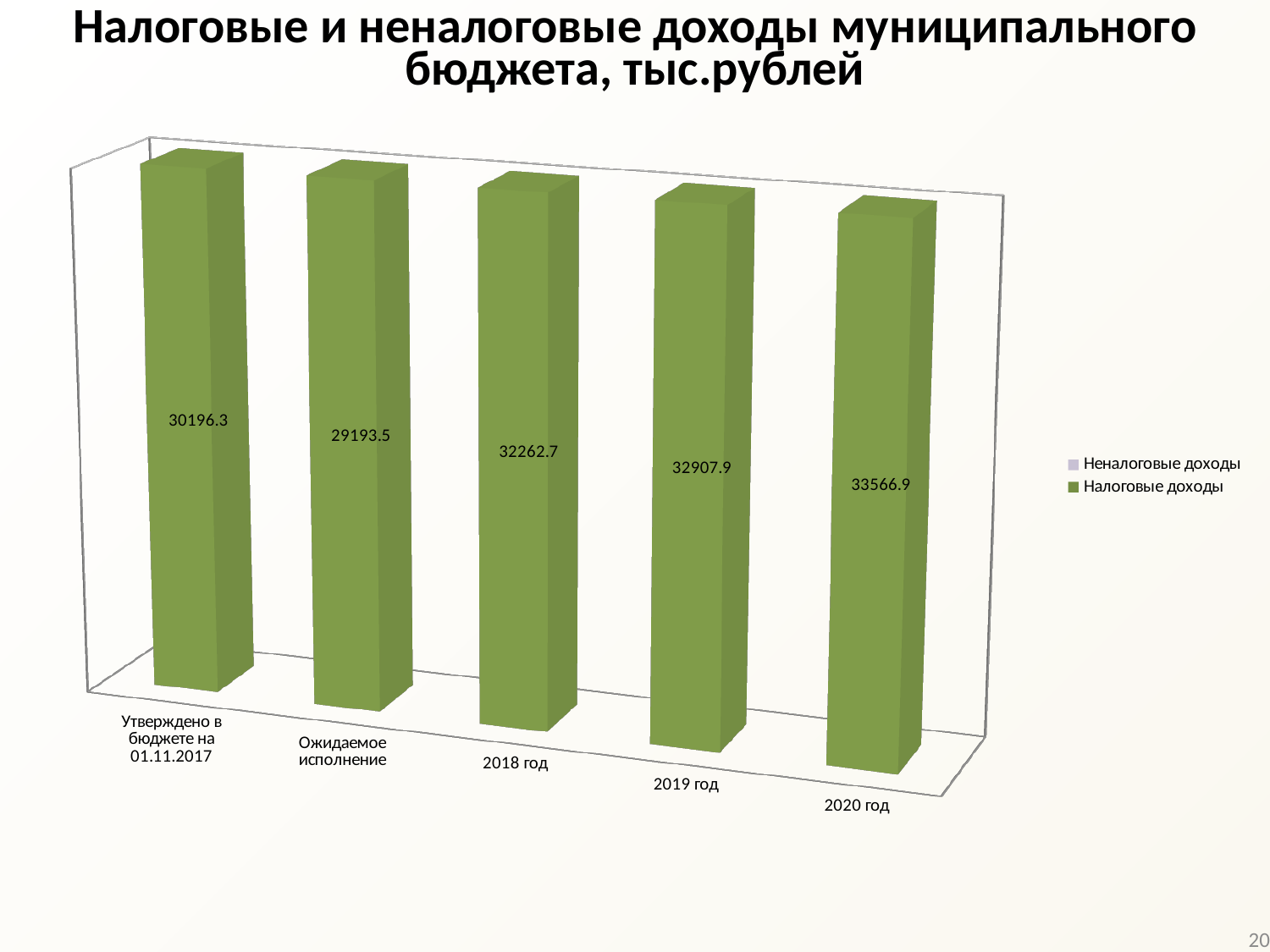
What is the value of Налоговые доходы for 2018 год? 32262.7 How many categories are shown on the x axis of the chart? 5 What is the difference between the Налоговые доходы values for 2020 год and Утверждено в бюджете на 01.11.2017? 3370.6 What is the difference between the Налоговые доходы values for 2019 год and 2018 год? 645.2 What is the value of Налоговые доходы for 2020 год? 33566.9 What kind of chart is shown on the slide? Bar chart How many series does the legend list? 2 Which is larger, the Налоговые доходы value for 2019 год or for 2018 год? 2019 год What is the value of Налоговые доходы for Утверждено в бюджете на 01.11.2017? 30196.3 Which category has the lowest value of Налоговые доходы? Ожидаемое исполнение What is the value of Налоговые доходы for Ожидаемое исполнение? 29193.5 Which category has the highest value of Налоговые доходы? 2020 год